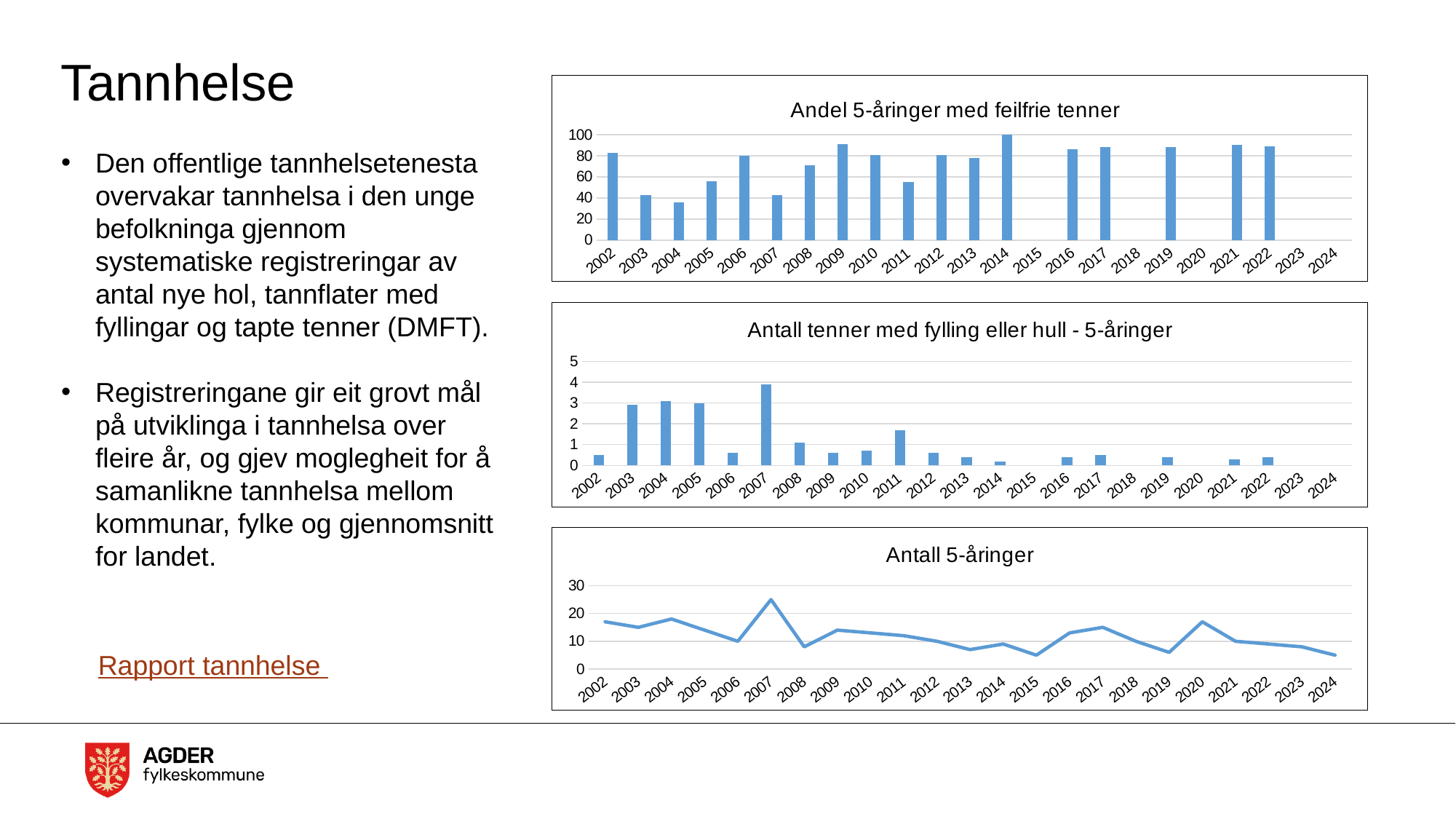
How many years are shown on the x axis of the bottom chart 'Antall 5-åringer'? 23 In the middle chart 'Antall tenner med fylling eller hull - 5-åringer', which year has the highest value? 2007 In the top chart 'Andel 5-åringer med feilfrie tenner', which year has the highest value? 2014 In the bottom chart 'Antall 5-åringer', do the values overall rise or fall from 2002 to 2024? fall In the bottom chart 'Antall 5-åringer', is the value for 2007 greater or less than 20? greater In the middle chart 'Antall tenner med fylling eller hull - 5-åringer', is the value for 2003 greater or less than 2? greater In the bottom chart 'Antall 5-åringer', which year has the highest value? 2007 In the middle chart 'Antall tenner med fylling eller hull - 5-åringer', which year has the larger value, 2007 or 2011? 2007 What kind of chart is the top chart, 'Andel 5-åringer med feilfrie tenner'? bar chart In the top chart 'Andel 5-åringer med feilfrie tenner', is the value for 2004 greater or less than 40? less What kind of chart is the bottom chart, 'Antall 5-åringer'? line chart